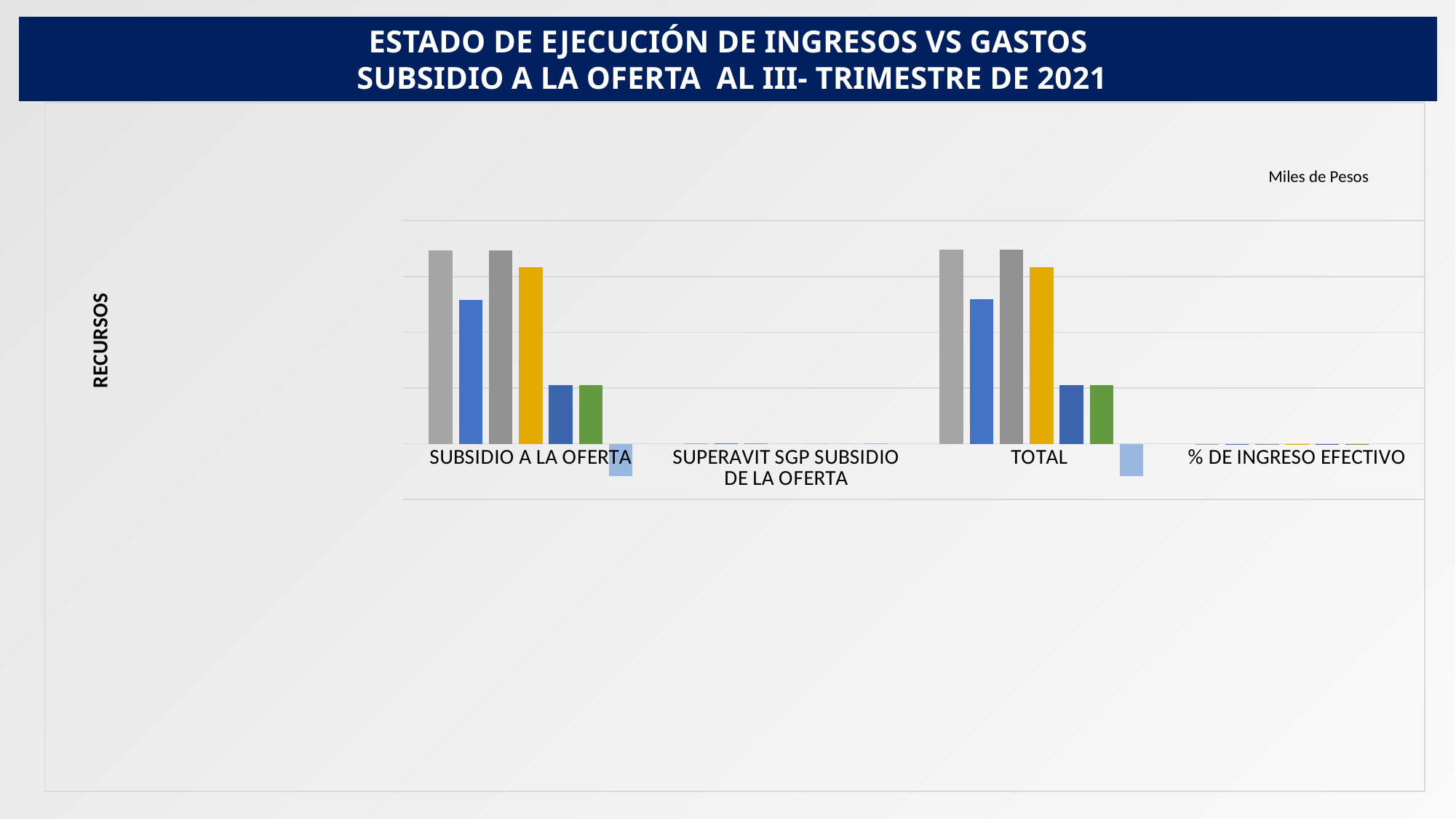
What is the label on the vertical axis of the chart? RECURSOS How many categories are shown on the x axis of the chart? 4 Which category has taller bars, TOTAL or % DE INGRESO EFECTIVO? TOTAL Which category has taller bars, SUBSIDIO A LA OFERTA or SUPERAVIT SGP SUBSIDIO DE LA OFERTA? SUBSIDIO A LA OFERTA What kind of chart is shown on the slide? bar chart What is the title of the chart? ESTADO DE EJECUCIÓN DE INGRESOS VS GASTOS SUBSIDIO A LA OFERTA AL III- TRIMESTRE DE 2021